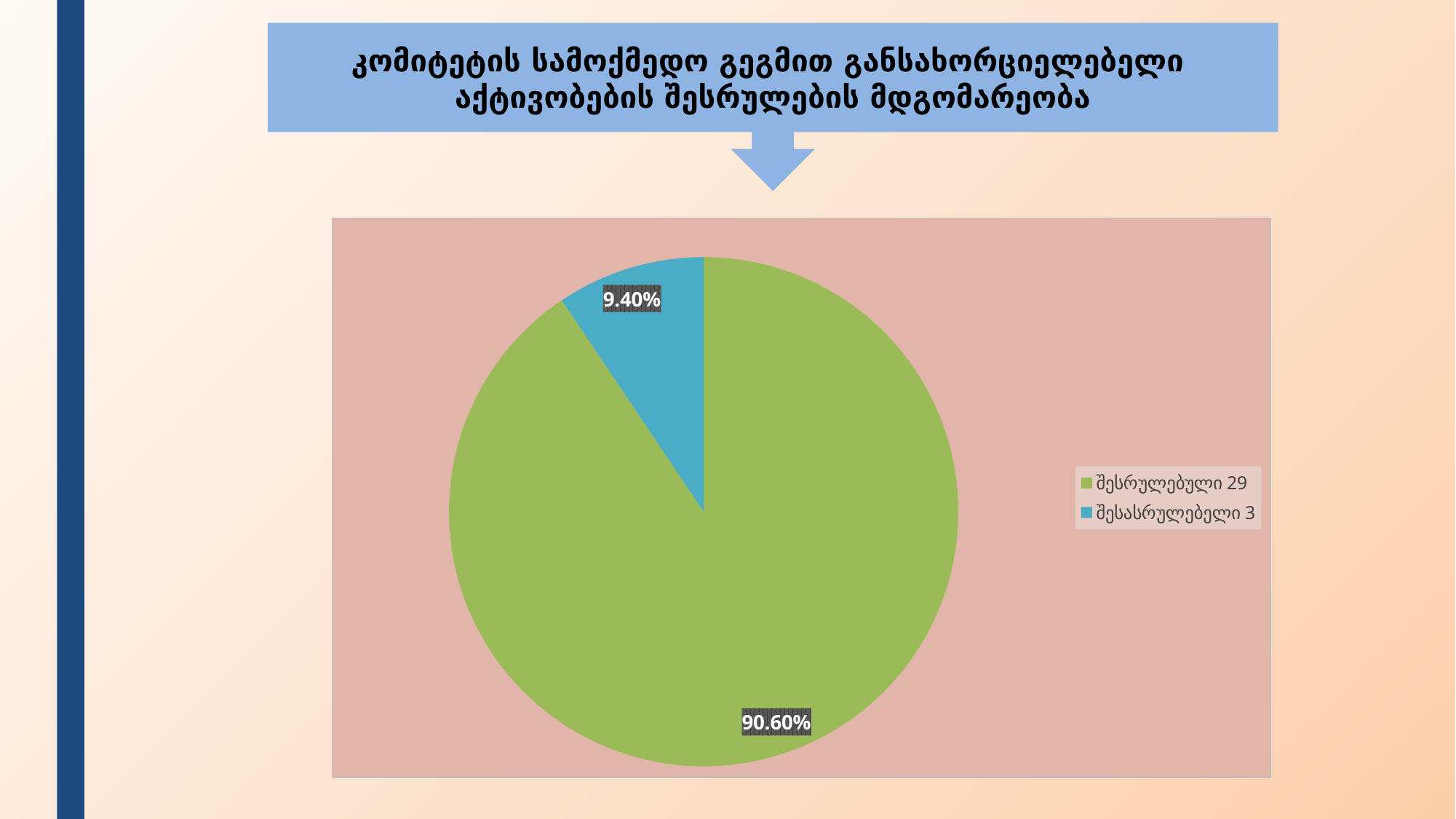
Which slice is larger, "შესრულებული 29" or "შესასრულებელი 3"? შესრულებული 29 Which slice of the pie is the largest? შესრულებული 29 How many entries does the legend list? 2 What colour is the slice labelled "შესრულებული 29"? green How many slices does the pie chart have? 2 What percentage share does the slice labelled "შესასრულებელი 3" have? 9.40% What colour is the slice labelled "შესასრულებელი 3"? blue What is the difference in percentage points between the "შესრულებული 29" slice and the "შესასრულებელი 3" slice? 81.20% What kind of chart is shown on the slide? pie chart What percentage share does the slice labelled "შესრულებული 29" have? 90.60% Which slice of the pie is the smallest? შესასრულებელი 3